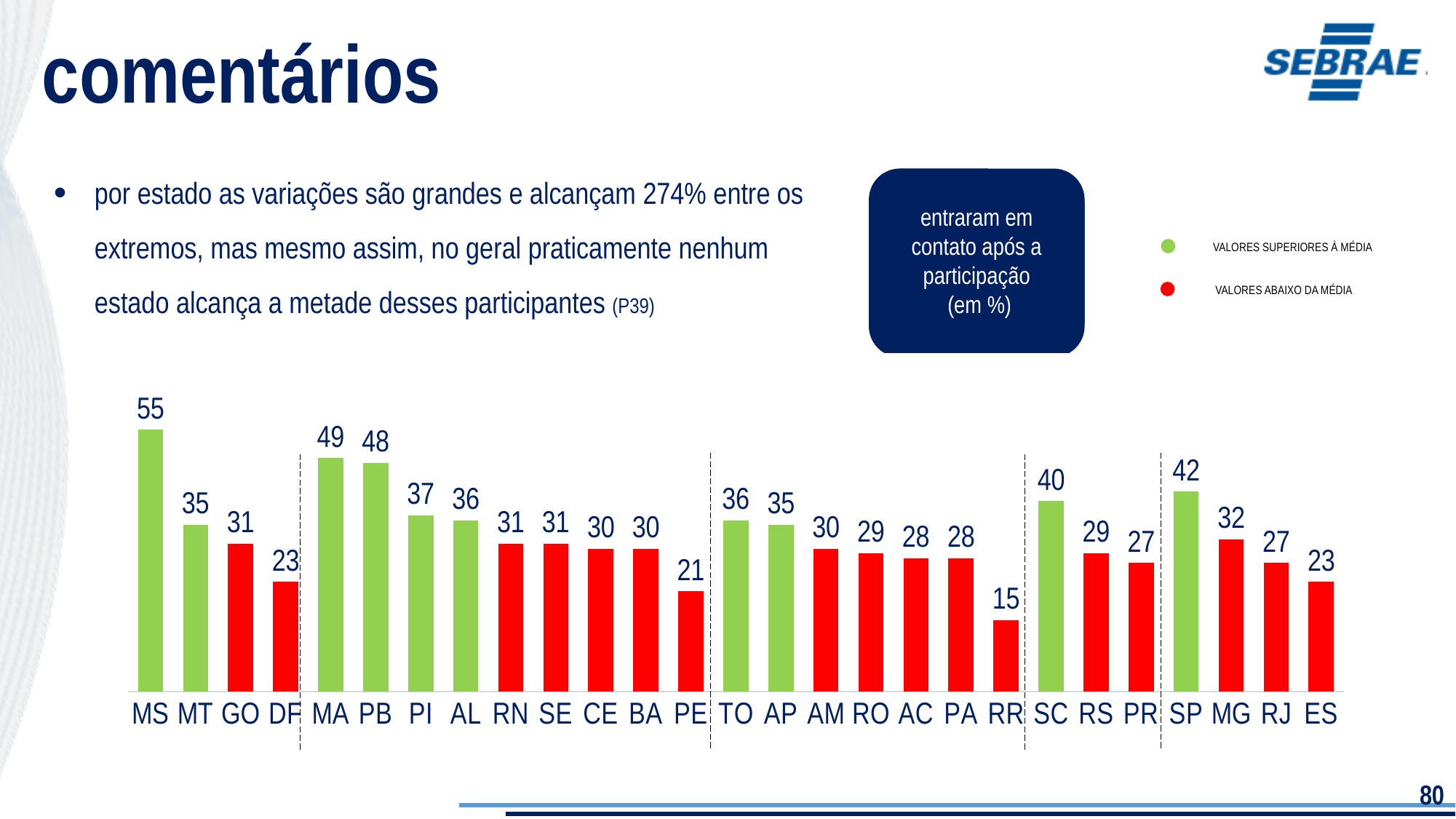
What is the difference between the values for MS and RR? 40 What is the difference between the values for MA and PE? 28 What does the green colour represent according to the legend? Valores superiores à média Which is larger, the value for SP or the value for SC? SP Which state has the lowest value? RR What is the value for RR? 15 How many states are shown on the x axis? 27 Which state has the highest value? MS How many entries does the legend list? 2 What kind of chart is shown? bar chart What is the value for SC? 40 What is the value for MS? 55